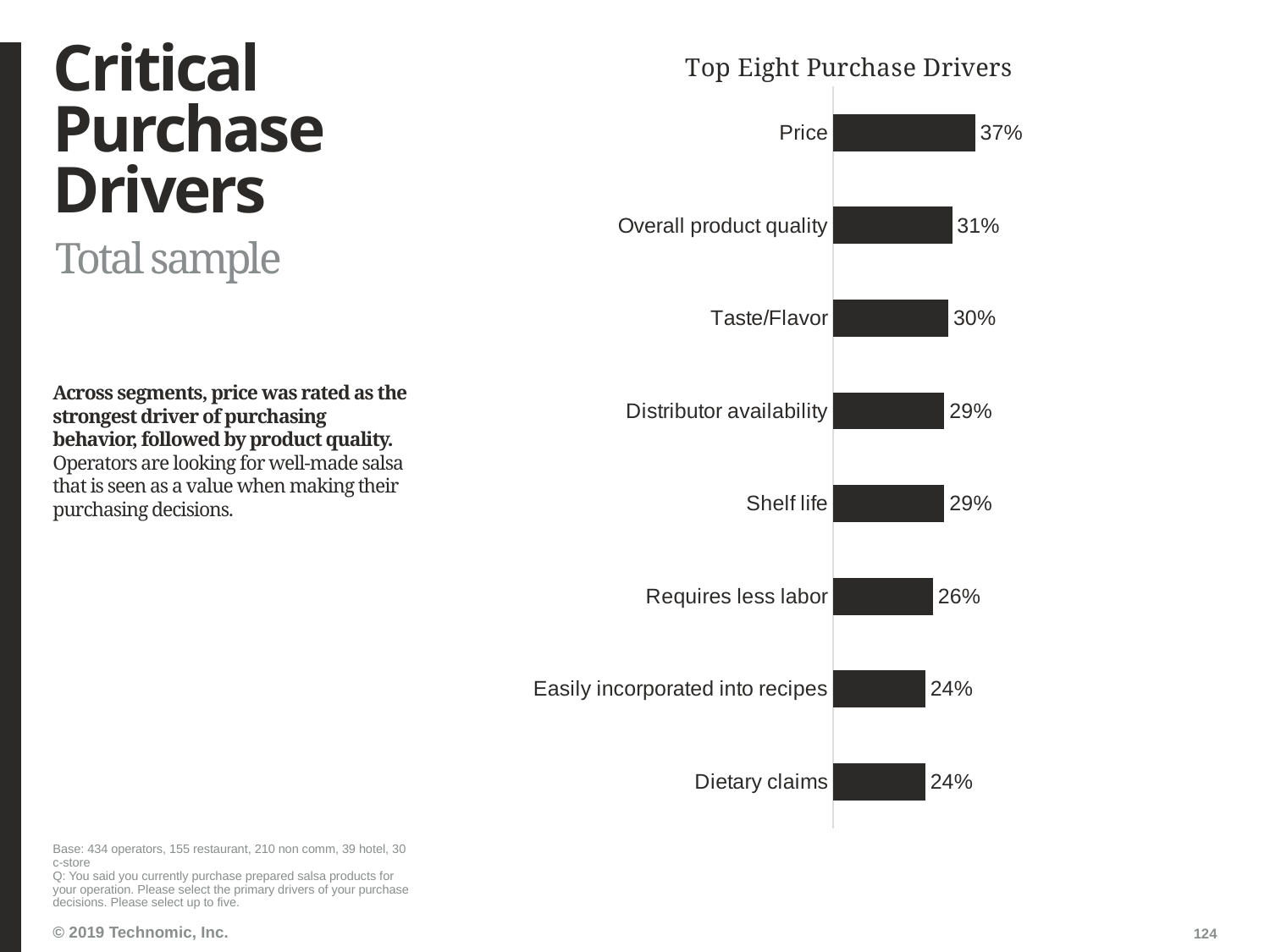
What is the difference between the values for Taste/Flavor and Dietary claims? 6% Which purchase driver has the highest value? Price What kind of chart is shown on the slide? Bar chart Which two purchase drivers both have a value of 24%? Easily incorporated into recipes and Dietary claims What is the value for Requires less labor? 26% What is the difference between the values for Price and Overall product quality? 6% What is the title of the chart? Top Eight Purchase Drivers Which is larger, the value for Taste/Flavor or the value for Requires less labor? Taste/Flavor What is the value for Overall product quality? 31% What is the value for Shelf life? 29% How many purchase drivers are shown in the chart? 8 What is the value for Price? 37%